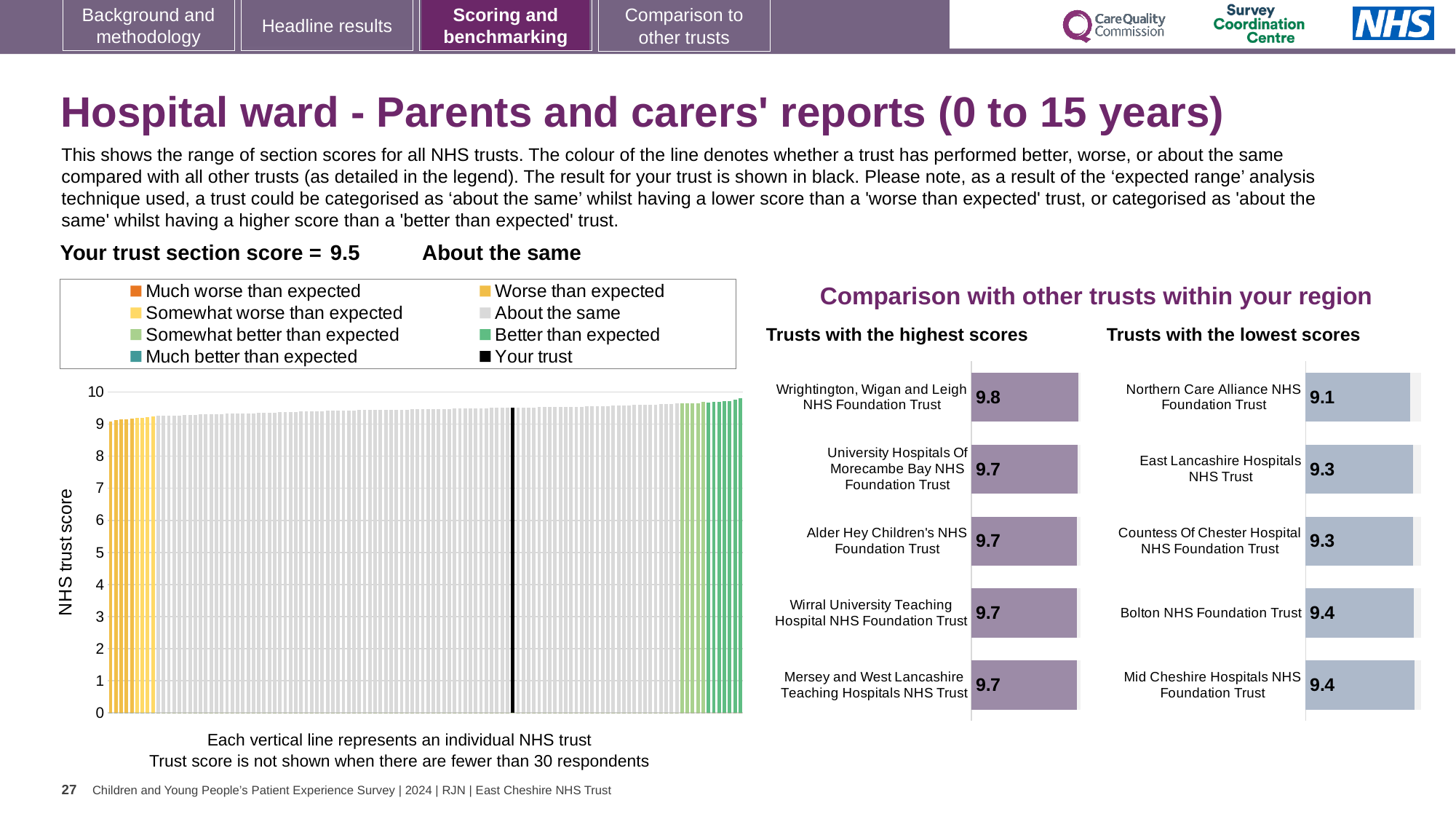
What kind of chart is the large chart on the left showing NHS trust scores? bar chart In the 'Trusts with the lowest scores' chart, which trust has the lowest score? Northern Care Alliance NHS Foundation Trust In the 'Trusts with the lowest scores' chart, what is the score for Countess Of Chester Hospital NHS Foundation Trust? 9.3 In the large chart on the left, is the value of the black bar (your trust) greater or less than 8? greater In the 'Trusts with the lowest scores' chart, what is the score for Northern Care Alliance NHS Foundation Trust? 9.1 In the 'Trusts with the lowest scores' chart, which has the larger score: East Lancashire Hospitals NHS Trust or Bolton NHS Foundation Trust? Bolton NHS Foundation Trust In the 'Trusts with the highest scores' chart, how many trusts are listed? 5 In the 'Trusts with the highest scores' chart, which trust has the highest score? Wrightington, Wigan and Leigh NHS Foundation Trust In the large chart on the left, how many entries does the legend list? 8 In the 'Trusts with the highest scores' chart, what is the score for Wrightington, Wigan and Leigh NHS Foundation Trust? 9.8 In the 'Trusts with the lowest scores' chart, what is the difference between the scores of Mid Cheshire Hospitals NHS Foundation Trust and Northern Care Alliance NHS Foundation Trust? 0.3 In the 'Trusts with the highest scores' chart, what is the difference between the scores of Wrightington, Wigan and Leigh NHS Foundation Trust and Alder Hey Children's NHS Foundation Trust? 0.1